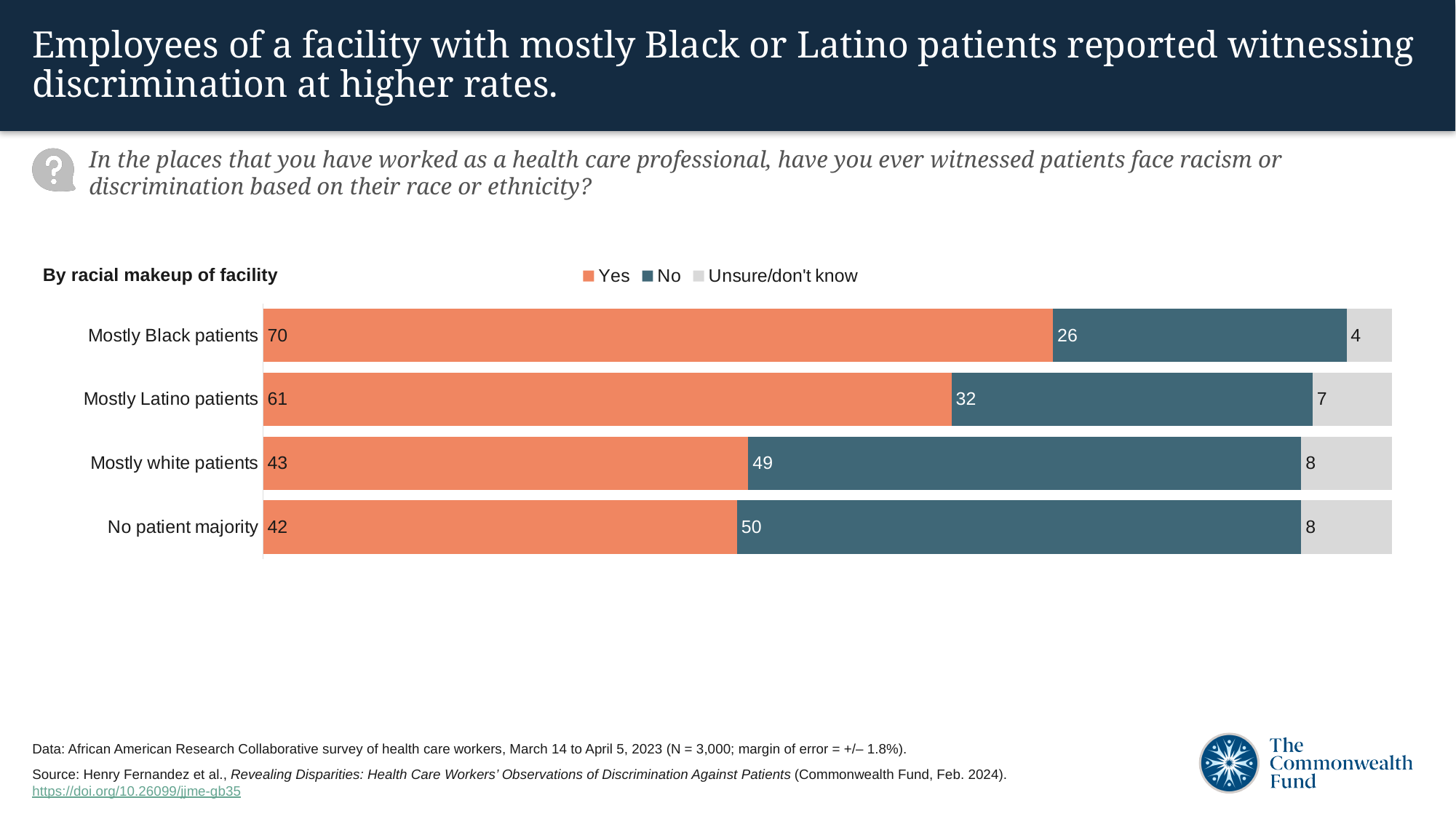
Which facility type has the lowest "Unsure/don't know" value? Mostly Black patients What is the "Unsure/don't know" value for Mostly Latino patients? 7 What kind of chart is shown on the slide? Stacked bar chart What is the "No" value for Mostly white patients? 49 Which colour represents the "Yes" series in the chart? Orange What is the total of the stacked bar for Mostly Black patients? 100 What is the "Yes" value for Mostly Black patients? 70 What is the difference between the "Yes" values for Mostly Black patients and Mostly white patients? 27 Which facility type has the highest "Yes" value? Mostly Black patients Which is larger: the "No" value for Mostly Latino patients or the "No" value for No patient majority? No patient majority How many facility categories are shown in the chart? 4 How many series does the legend list? 3